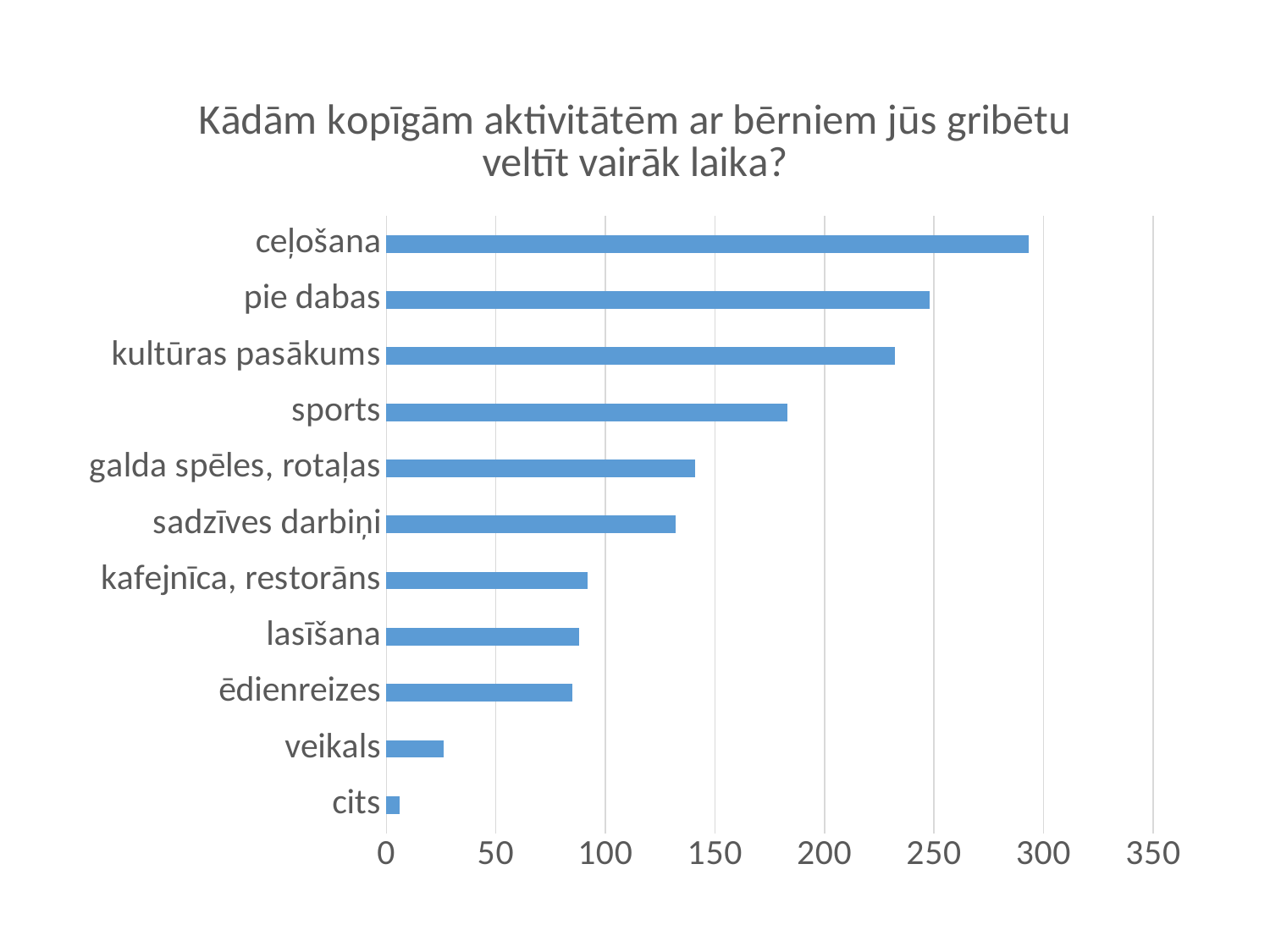
Which category has the highest value? ceļošana Is the value for sports greater or less than 150? greater Is the value for kafejnīca, restorāns greater or less than 100? less Which category has the lowest value? cits What is the title of the chart? Kādām kopīgām aktivitātēm ar bērniem jūs gribētu veltīt vairāk laika? Is the value for veikals greater or less than 50? less Which has a larger value, sports or galda spēles, rotaļas? sports Which has a larger value, kultūras pasākums or sadzīves darbiņi? kultūras pasākums How many categories are shown in the chart? 11 What kind of chart is shown on the slide? bar chart